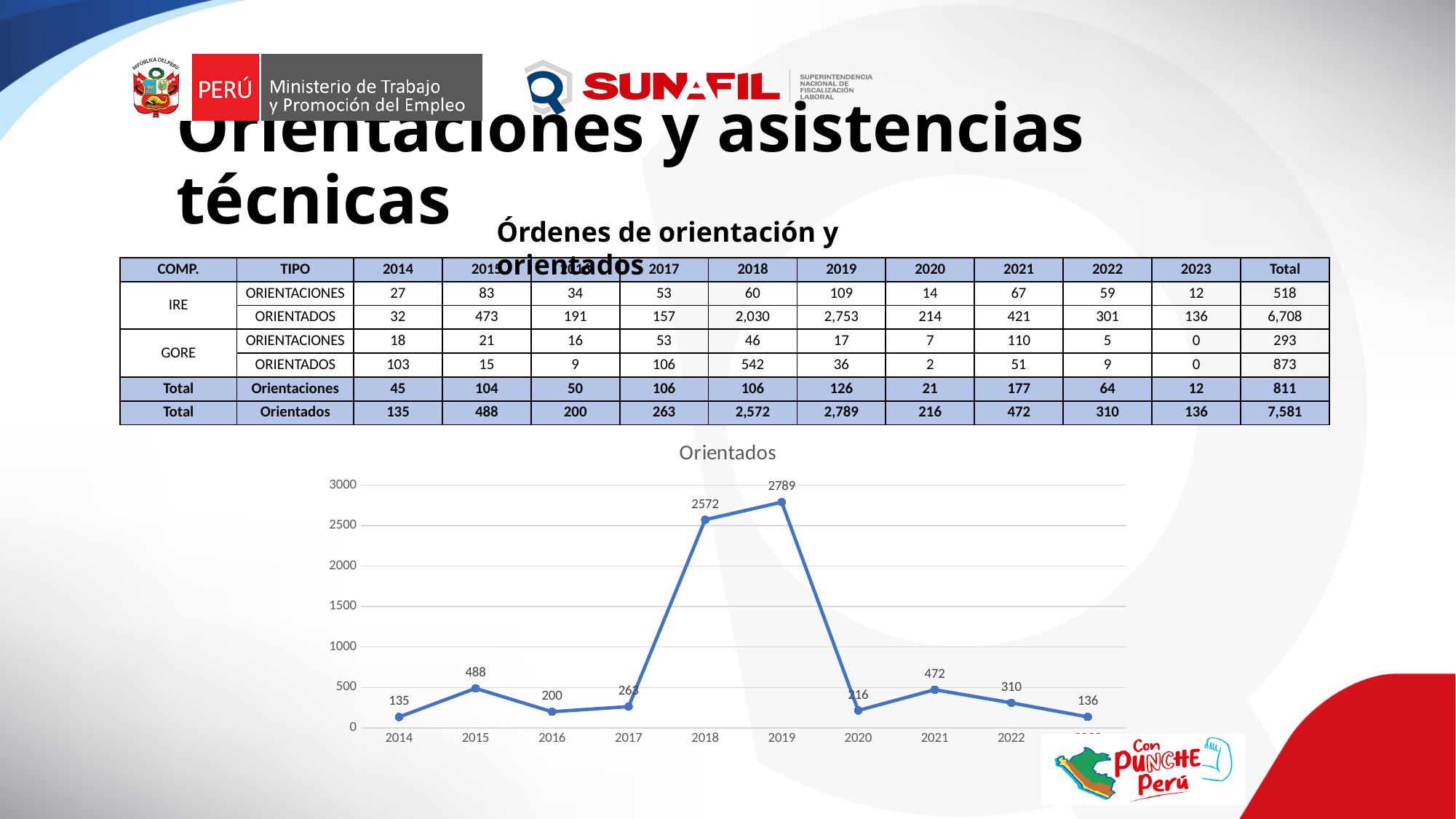
What is the difference between the values for 2019 and 2018 in the Orientados chart? 217 What is the title of the chart on the slide? Orientados Does the value in the Orientados chart rise or fall from 2019 to 2020? fall How many data points are plotted in the Orientados chart? 10 What kind of chart is the Orientados chart? line chart What is the value for 2020 in the Orientados chart? 216 Which year has the highest value in the Orientados chart? 2019 What is the value for 2015 in the Orientados chart? 488 Which is larger in the Orientados chart, the value for 2021 or the value for 2022? 2021 What is the difference between the values for 2015 and 2014 in the Orientados chart? 353 Is the value for 2017 in the Orientados chart greater or less than 500? less What is the value for 2018 in the Orientados chart? 2572